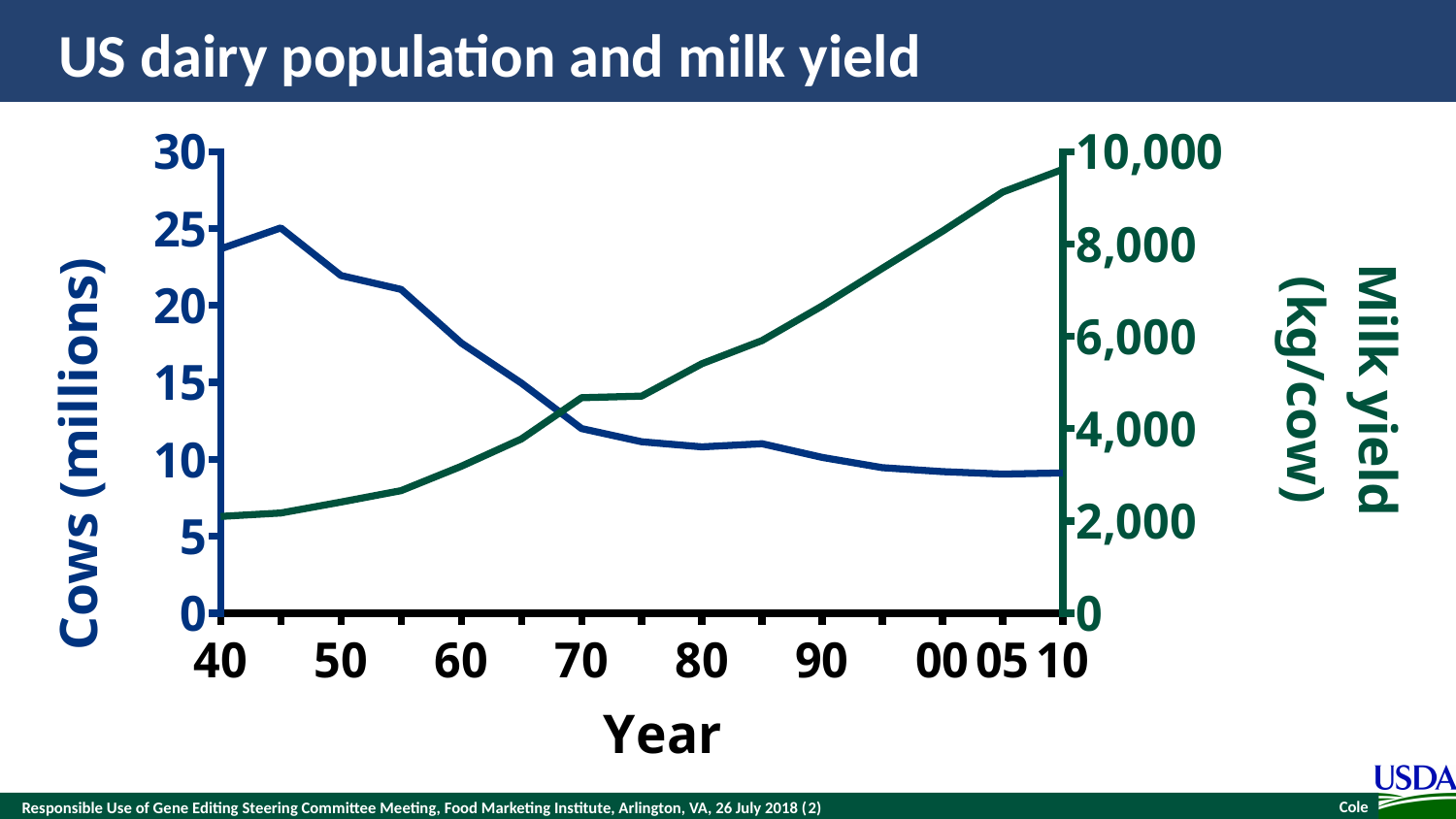
Which is larger, the number of cows in year 40 or in year 70? year 40 Does the Milk yield (kg/cow) line rise or fall overall from 1940 to 2010? rise Does the Cows (millions) line rise or fall overall from 1940 to 2010? fall Is the value for Cows (millions) in year 60 greater or less than 20? less What kind of chart is shown on the slide? line chart How many year labels are shown on the x axis? 9 Is the value for Milk yield (kg/cow) in year 70 greater or less than 4,000? greater What is the title of the chart? US dairy population and milk yield Is the value for Cows (millions) in year 10 greater or less than 10? less What is the label of the right-hand vertical axis? Milk yield (kg/cow) In which year is milk yield (kg/cow) highest? 10